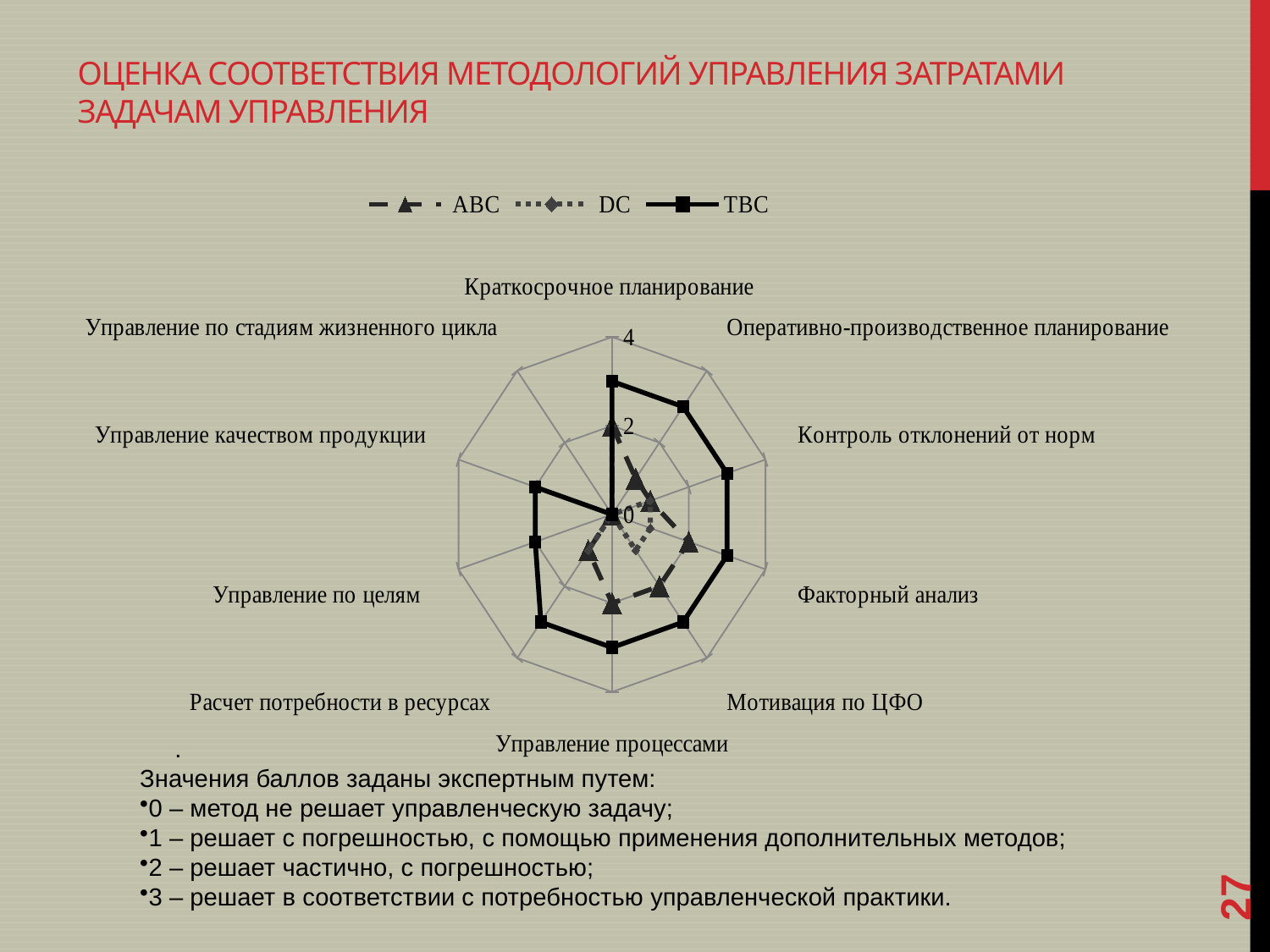
For Краткосрочное планирование, which series has the larger value, TBC or ABC? TBC Is the TBC value for Контроль отклонений от норм greater or less than 2? greater Is the TBC value for Краткосрочное планирование greater or less than 2? greater What is the highest value shown on the radial axis? 4 How many series does the legend list? 3 How many categories (axes) does the radar chart have? 10 What kind of chart is shown on the slide? Radar chart For Факторный анализ, which series has the larger value, TBC or DC? TBC Which series are listed in the legend? ABC, DC, TBC Is the TBC value for Управление по стадиям жизненного цикла greater or less than 2? less